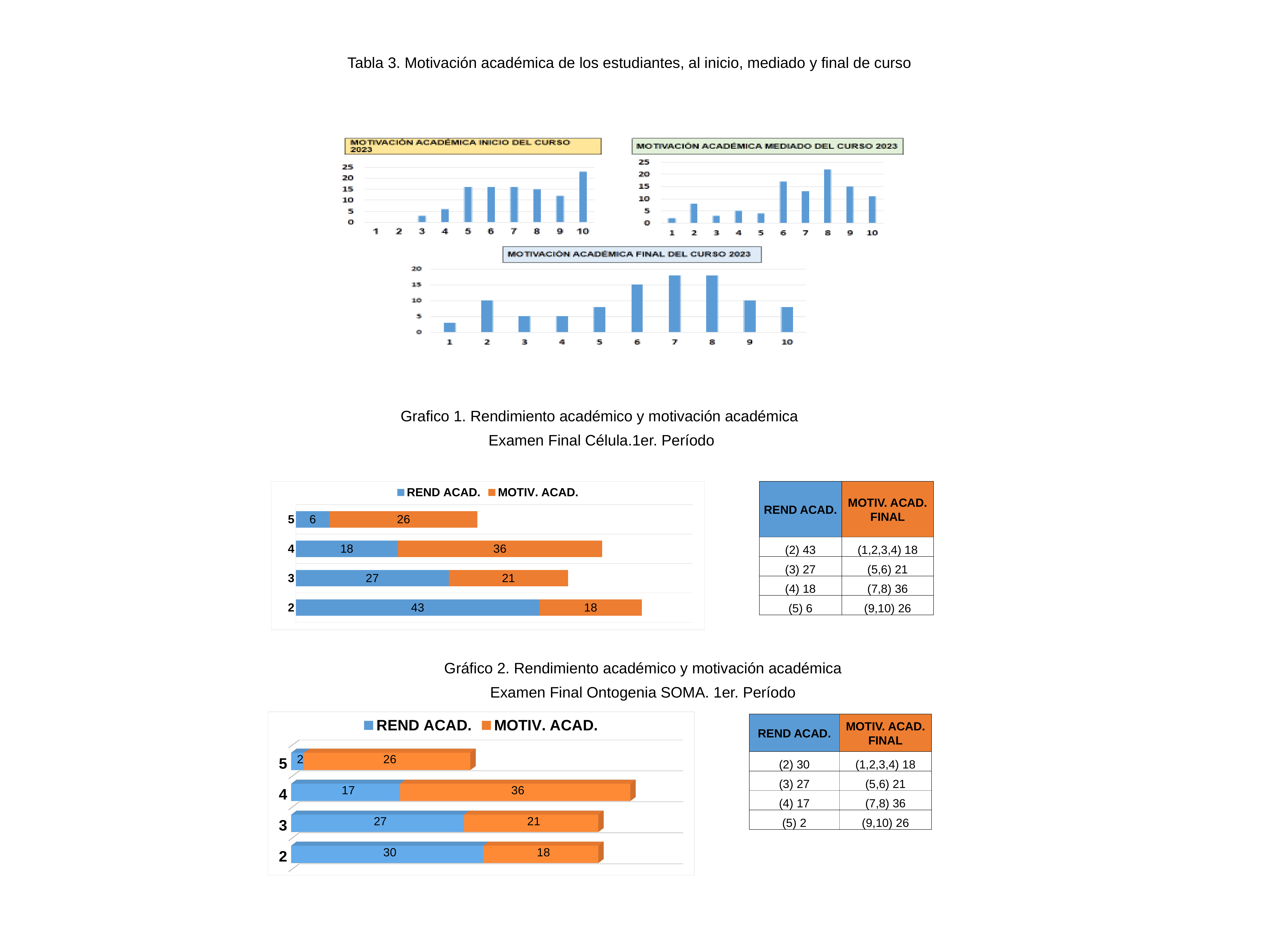
In Grafico 1 (Examen Final Célula), what is the MOTIV. ACAD. value for category 4? 36 In Grafico 1 (Examen Final Célula), which category has the lowest REND ACAD. value? 5 What kind of chart is Grafico 1 (Examen Final Célula)? Stacked bar chart In Gráfico 2 (Examen Final Ontogenia SOMA), what is the REND ACAD. value for category 5? 2 In Grafico 1 (Examen Final Célula), what is the REND ACAD. value for category 2? 43 In Grafico 1 (Examen Final Célula), what is the difference between the MOTIV. ACAD. values for category 4 and category 2? 18 In the chart titled MOTIVACIÓN ACADÉMICA INICIO DEL CURSO 2023, is the value for category 10 greater or less than 20? greater In Gráfico 2 (Examen Final Ontogenia SOMA), which category has the highest MOTIV. ACAD. value? 4 In Gráfico 2 (Examen Final Ontogenia SOMA), what is the total of the stacked bar for category 4? 53 In Gráfico 2 (Examen Final Ontogenia SOMA), how many series does the legend list? 2 In Grafico 1 (Examen Final Célula), what is the total of the stacked bar for category 3? 48 In the chart titled MOTIVACIÓN ACADÉMICA MEDIADO DEL CURSO 2023, which category has the highest value? 8